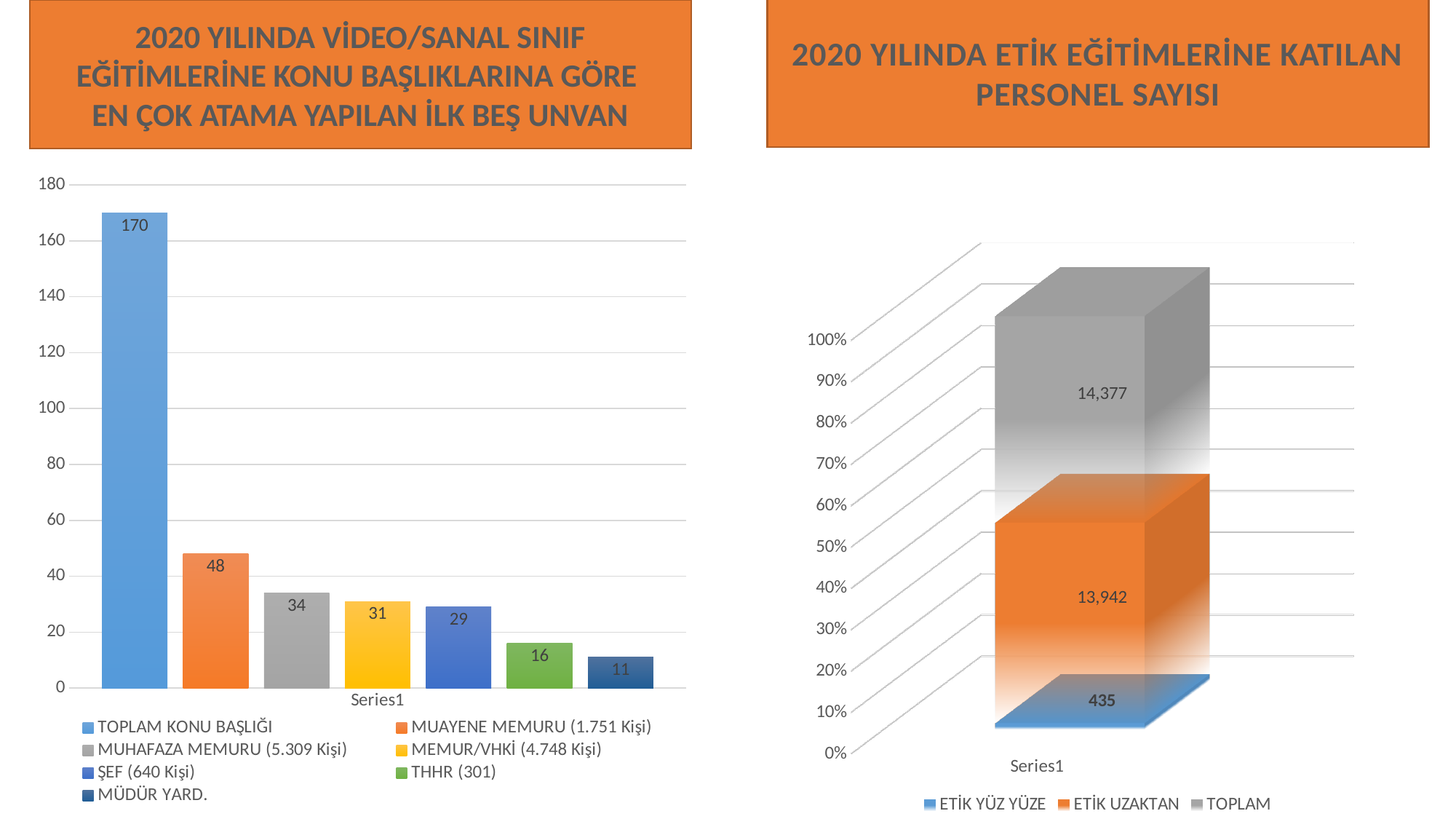
In the left chart, what is the value for ŞEF (640 Kişi)? 29 In the left chart, what is the difference between the values for MUHAFAZA MEMURU (5.309 Kişi) and THHR (301)? 18 In the right chart (2020 YILINDA ETİK EĞİTİMLERİNE KATILAN PERSONEL SAYISI), what is the value for ETİK UZAKTAN? 13,942 In the left chart, what is the value for MUAYENE MEMURU (1.751 Kişi)? 48 In the right chart, what is the value for ETİK YÜZ YÜZE? 435 In the left chart, what type of chart is shown? Bar chart In the right chart, what is the value labelled for TOPLAM? 14,377 In the right chart, how many series does the legend list? 3 In the left chart (2020 YILINDA VİDEO/SANAL SINIF EĞİTİMLERİNE...), what is the value for TOPLAM KONU BAŞLIĞI? 170 In the left chart, how many bars are plotted? 7 In the left chart, which legend entry has the lowest value? MÜDÜR YARD. In the left chart, which is larger: MEMUR/VHKİ (4.748 Kişi) or THHR (301)? MEMUR/VHKİ (4.748 Kişi)